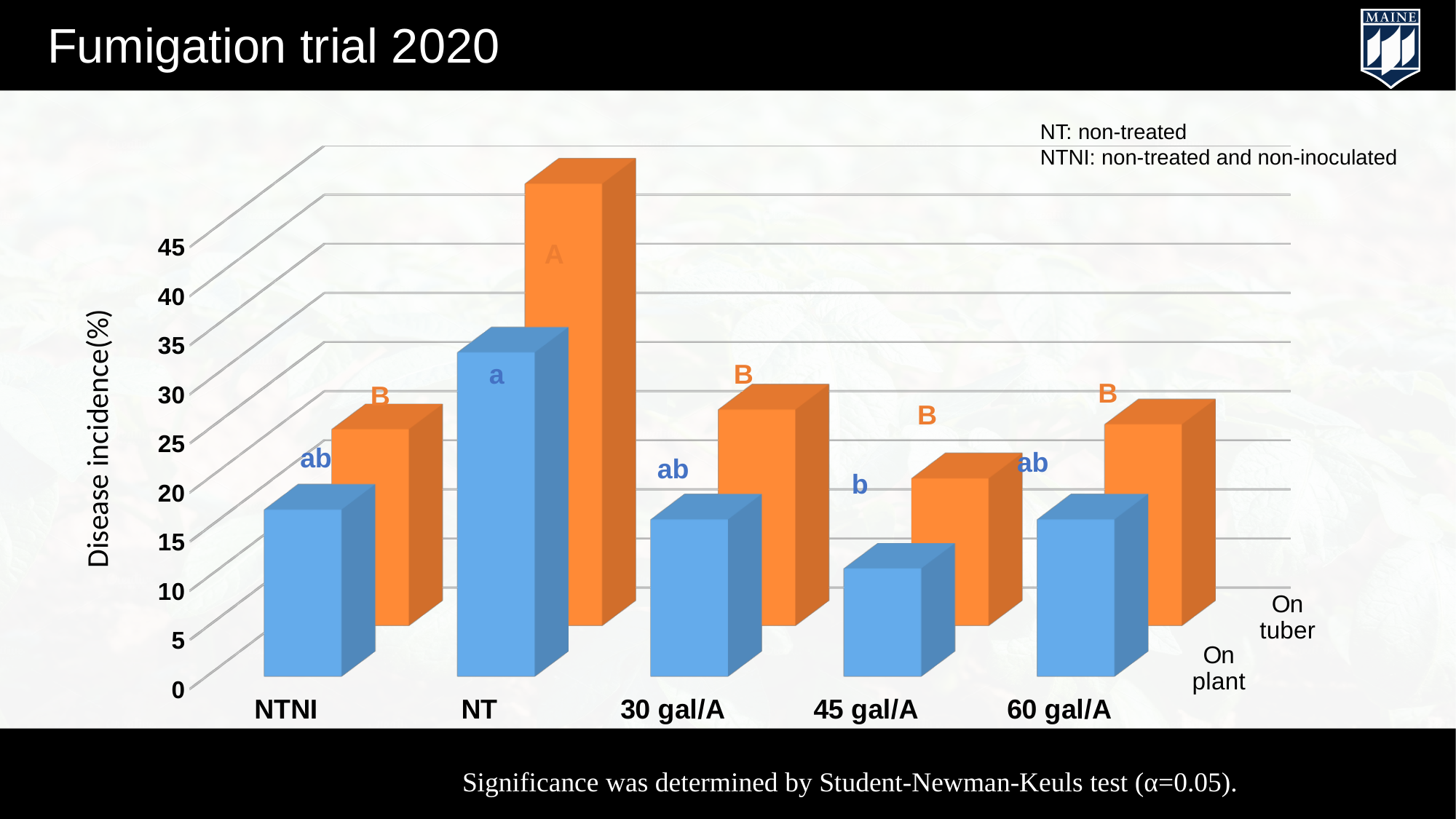
For NT, which is larger, the disease incidence on plant or on tuber? On tuber Is the disease incidence on plant for 45 gal/A greater or less than 15? less Which treatment has the highest disease incidence on plant? NT How many series does the chart show? 2 Which is larger, the disease incidence on plant for NT or for NTNI? NT What is the label of the vertical axis? Disease incidence(%) Which treatment has the highest disease incidence on tuber? NT Is the disease incidence on tuber for NT greater or less than 35? greater Which treatment has the lowest disease incidence on plant? 45 gal/A Is the disease incidence on plant for NT greater or less than 30? greater What kind of chart is shown on the slide? bar chart How many treatment categories are shown on the x axis? 5